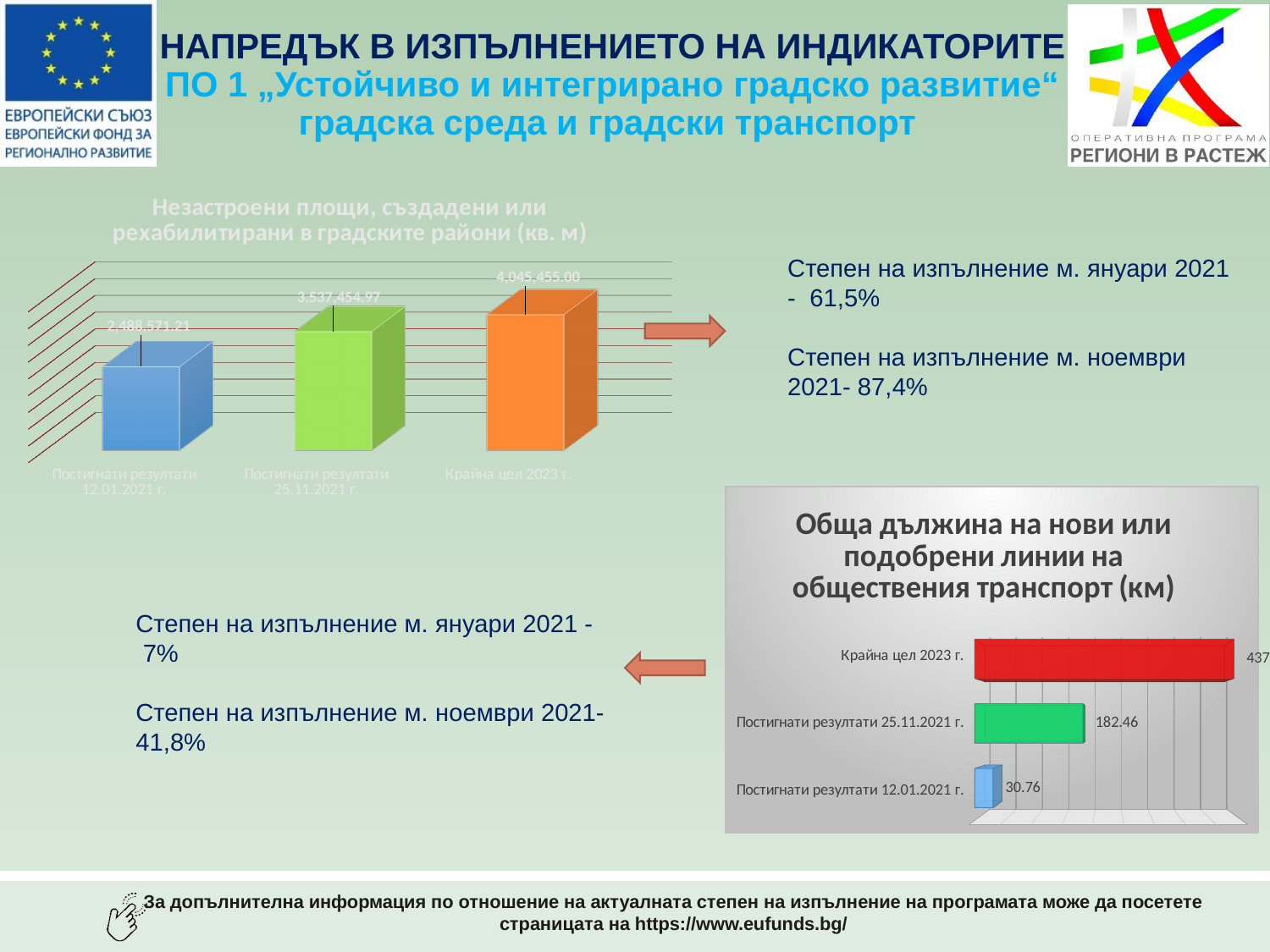
What kind of chart is the one titled "Обща дължина на нови или подобрени линии на обществения транспорт (км)"? Bar chart In the chart titled "Обща дължина на нови или подобрени линии на обществения транспорт (км)", what is the value for "Крайна цел 2023 г."? 437 In the chart titled "Незастроени площи, създадени или рехабилитирани в градските райони (кв. м)", what is the value for "Постигнати резултати 25.11.2021 г."? 3,537,454.97 In the chart titled "Обща дължина на нови или подобрени линии на обществения транспорт (км)", what is the value for "Постигнати резултати 12.01.2021 г."? 30.76 In the chart titled "Обща дължина на нови или подобрени линии на обществения транспорт (км)", what is the difference between "Крайна цел 2023 г." and "Постигнати резултати 25.11.2021 г."? 254.54 In the chart titled "Незастроени площи, създадени или рехабилитирани в градските райони (кв. м)", what is the value for "Постигнати резултати 12.01.2021 г."? 2,488,571.21 In the chart titled "Обща дължина на нови или подобрени линии на обществения транспорт (км)", what is the value for "Постигнати резултати 25.11.2021 г."? 182.46 In the chart titled "Незастроени площи, създадени или рехабилитирани в градските райони (кв. м)", which category has the highest value? Крайна цел 2023 г. In the chart titled "Незастроени площи, създадени или рехабилитирани в градските райони (кв. м)", do the values rise or fall from left to right? Rise In the chart titled "Незастроени площи, създадени или рехабилитирани в градските райони (кв. м)", what is the value for "Крайна цел 2023 г."? 4,045,455.00 In the chart titled "Обща дължина на нови или подобрени линии на обществения транспорт (км)", which category has the lowest value? Постигнати резултати 12.01.2021 г. In the chart titled "Обща дължина на нови или подобрени линии на обществения транспорт (км)", how many bars are shown? 3